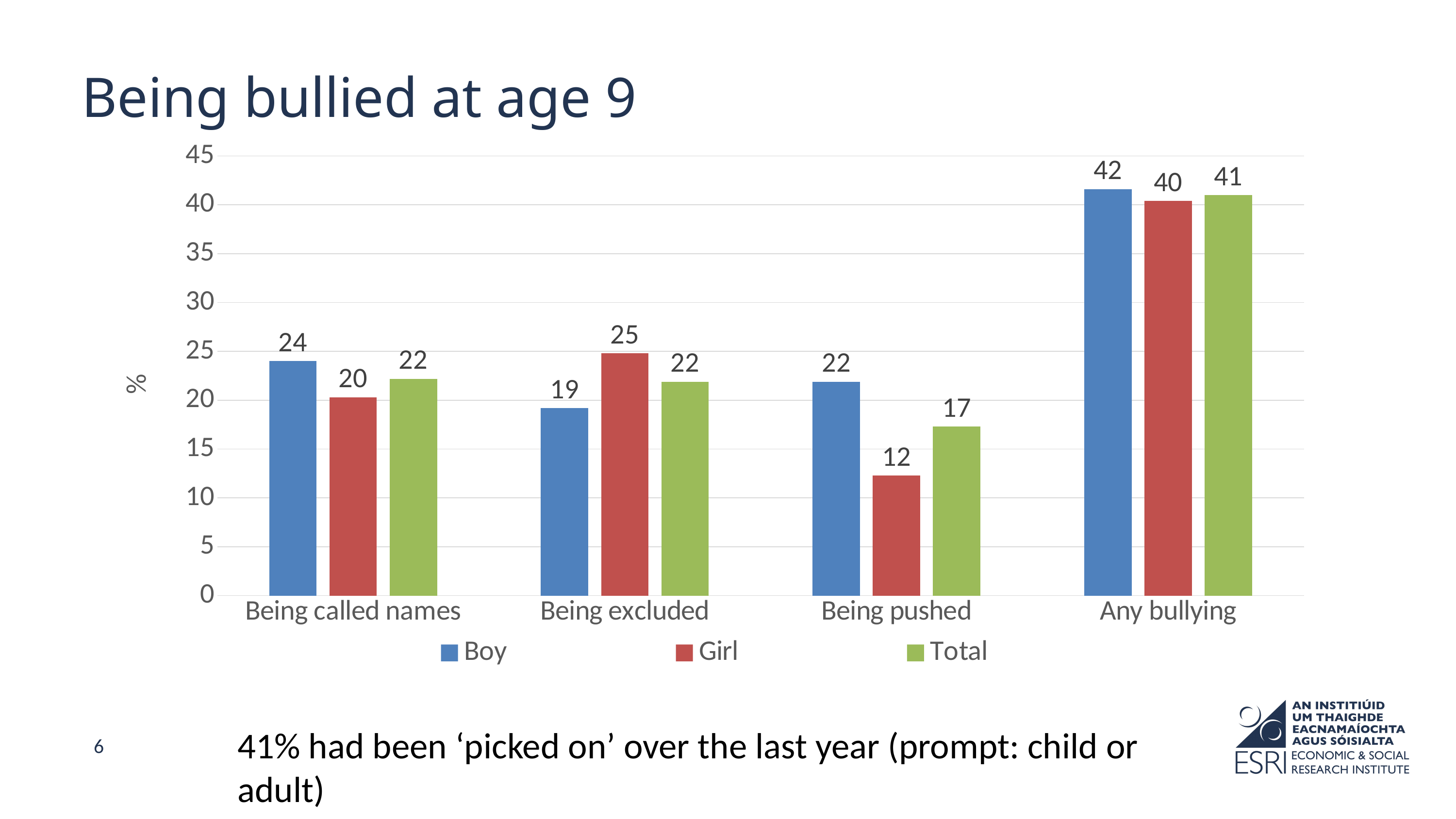
Which is larger for Being excluded, the Boy value or the Girl value? Girl How many series does the legend list? 3 What is the Total value for Any bullying? 41 What is the difference between the Boy and Girl values for Being pushed? 10 How many categories are shown on the x axis? 4 What is the value for Girl in the Being pushed category? 12 What is the value for Boy in the Being called names category? 24 Which category has the highest Girl value? Any bullying Which category has the lowest Total value? Being pushed What is the title of the chart? Being bullied at age 9 Is the Boy value for Any bullying greater or less than 40? greater What kind of chart is shown on the slide? Bar chart